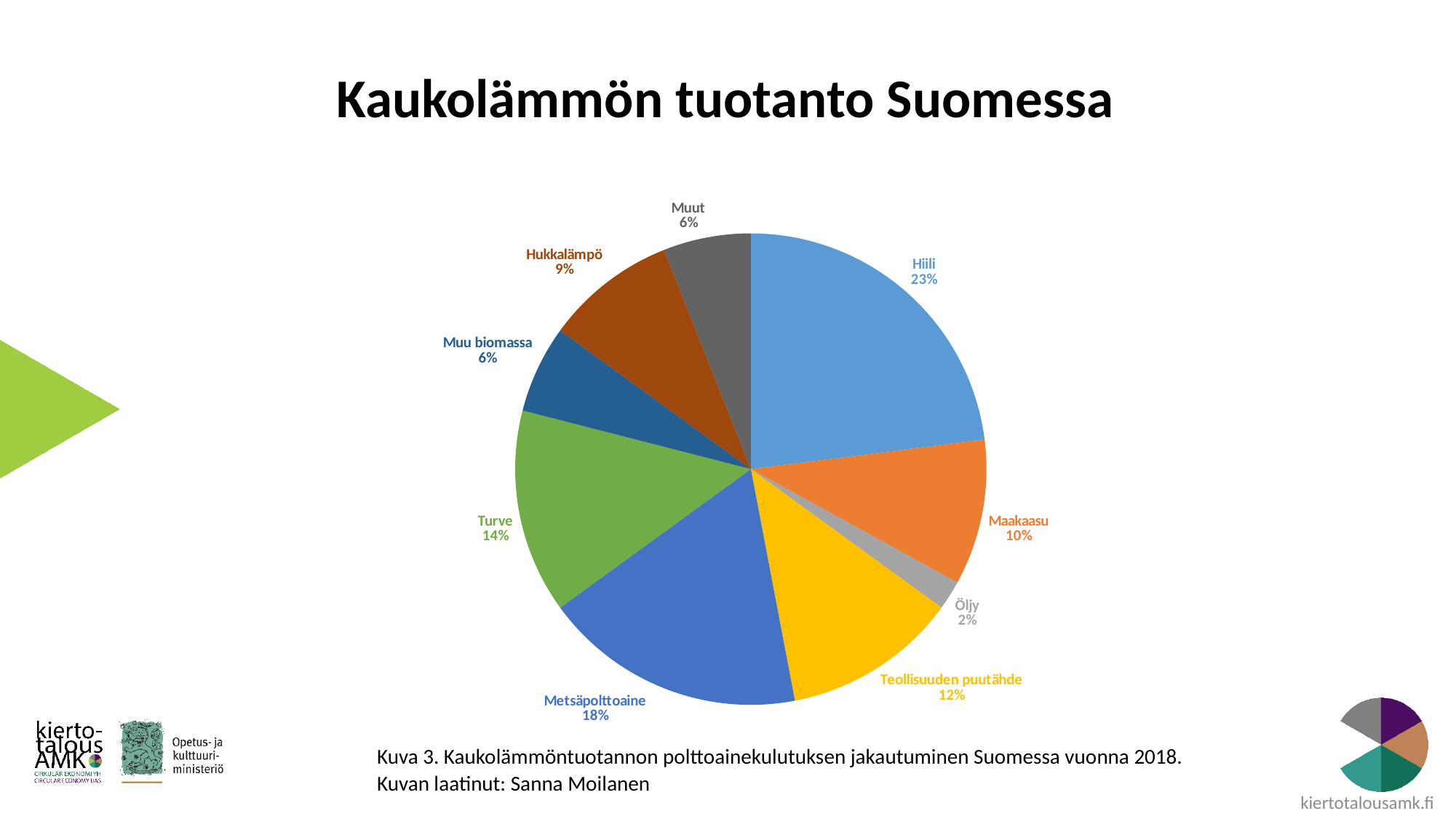
What is the title of the slide containing the pie chart? Kaukolämmön tuotanto Suomessa What is the value shown for Turve? 14% How many slices does the pie chart have? 9 What is the value shown for Metsäpolttoaine? 18% Which category has the largest slice of the pie? Hiili What is the value shown for Teollisuuden puutähde? 12% What is the difference between the shares of Hiili and Maakaasu? 13% What colour is the Turve slice? green Which category has the smallest slice of the pie? Öljy What share of the pie does Hiili have? 23% Which is larger, the share of Turve or the share of Hukkalämpö? Turve What kind of chart is shown on the slide? pie chart